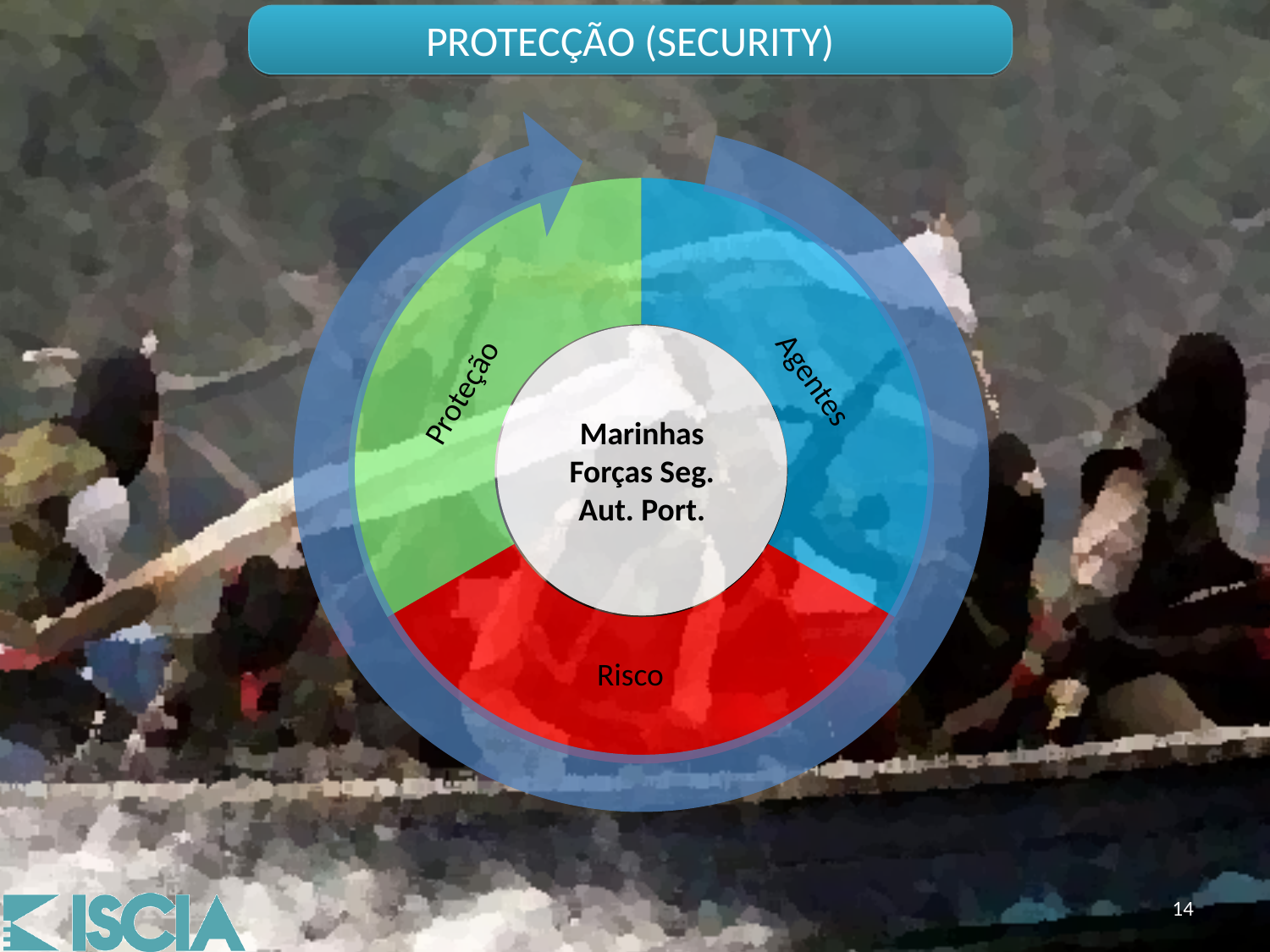
What colour is the segment labelled Risco? Red How many segments does the ring diagram have? 3 What are the labels of the three segments in the ring diagram? Proteção, Agentes, Risco What text appears in the centre of the ring diagram? Marinhas Forças Seg. Aut. Port.